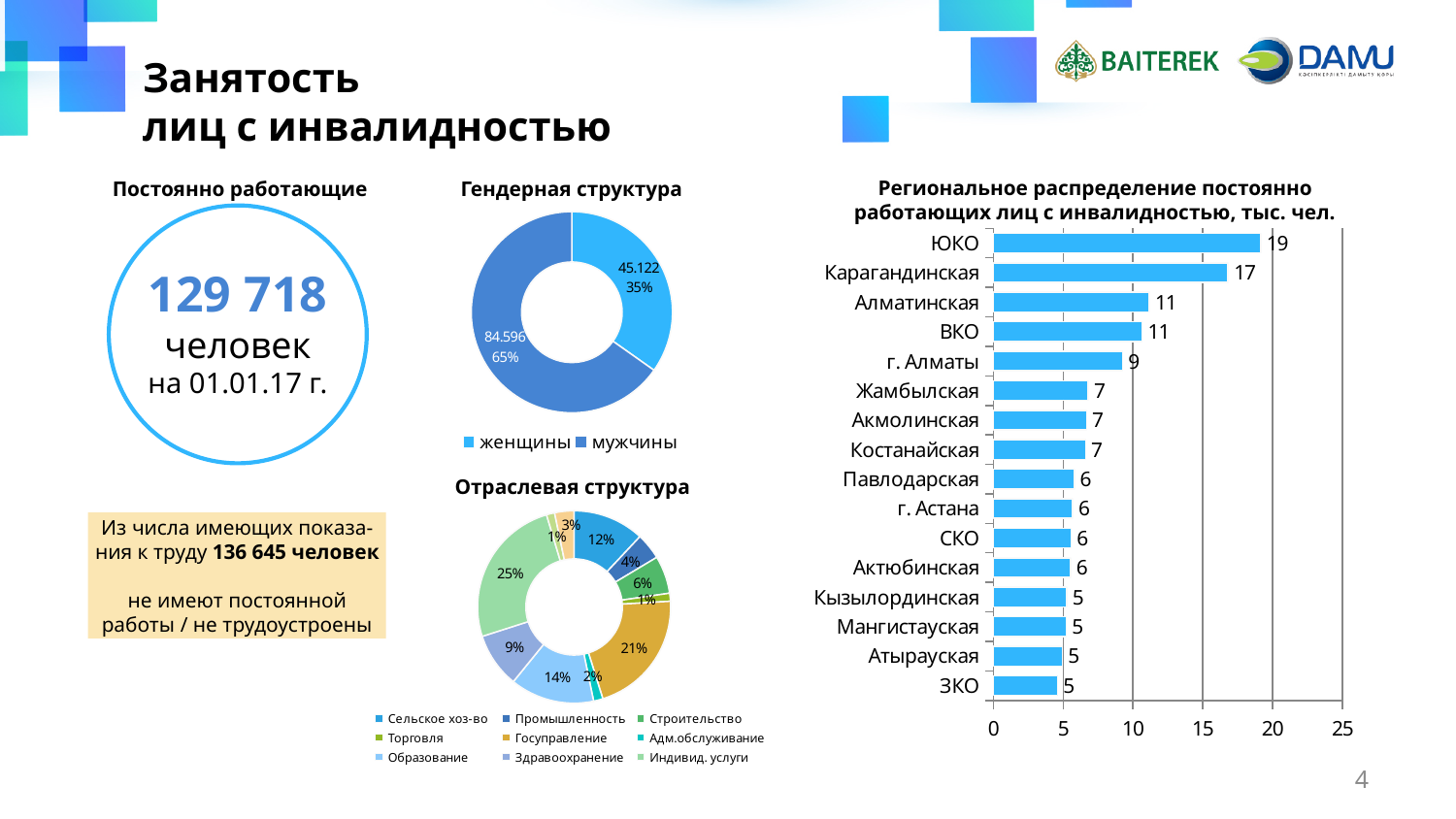
In the regional distribution bar chart, which region has the highest value? ЮКО In the regional distribution bar chart, what is the difference between the values for ЮКО and Карагандинская? 2 In the regional distribution bar chart, which is larger: the value for Алматинская or for Жамбылская? Алматинская In the 'Гендерная структура' chart, what is the value shown for мужчины? 84.596 How many entries does the legend of the 'Гендерная структура' chart list? 2 How many regions are shown in the regional distribution bar chart? 16 In the 'Гендерная структура' chart, what share do женщины make up? 35% In the regional distribution bar chart, what is the value for г. Алматы? 9 In the chart 'Региональное распределение постоянно работающих лиц с инвалидностью, тыс. чел.', what is the value for ЮКО? 19 What type of chart is 'Региональное распределение постоянно работающих лиц с инвалидностью, тыс. чел.'? Bar chart How many entries does the legend of the 'Отраслевая структура' chart list? 9 In the regional distribution bar chart, what is the value for Павлодарская? 6